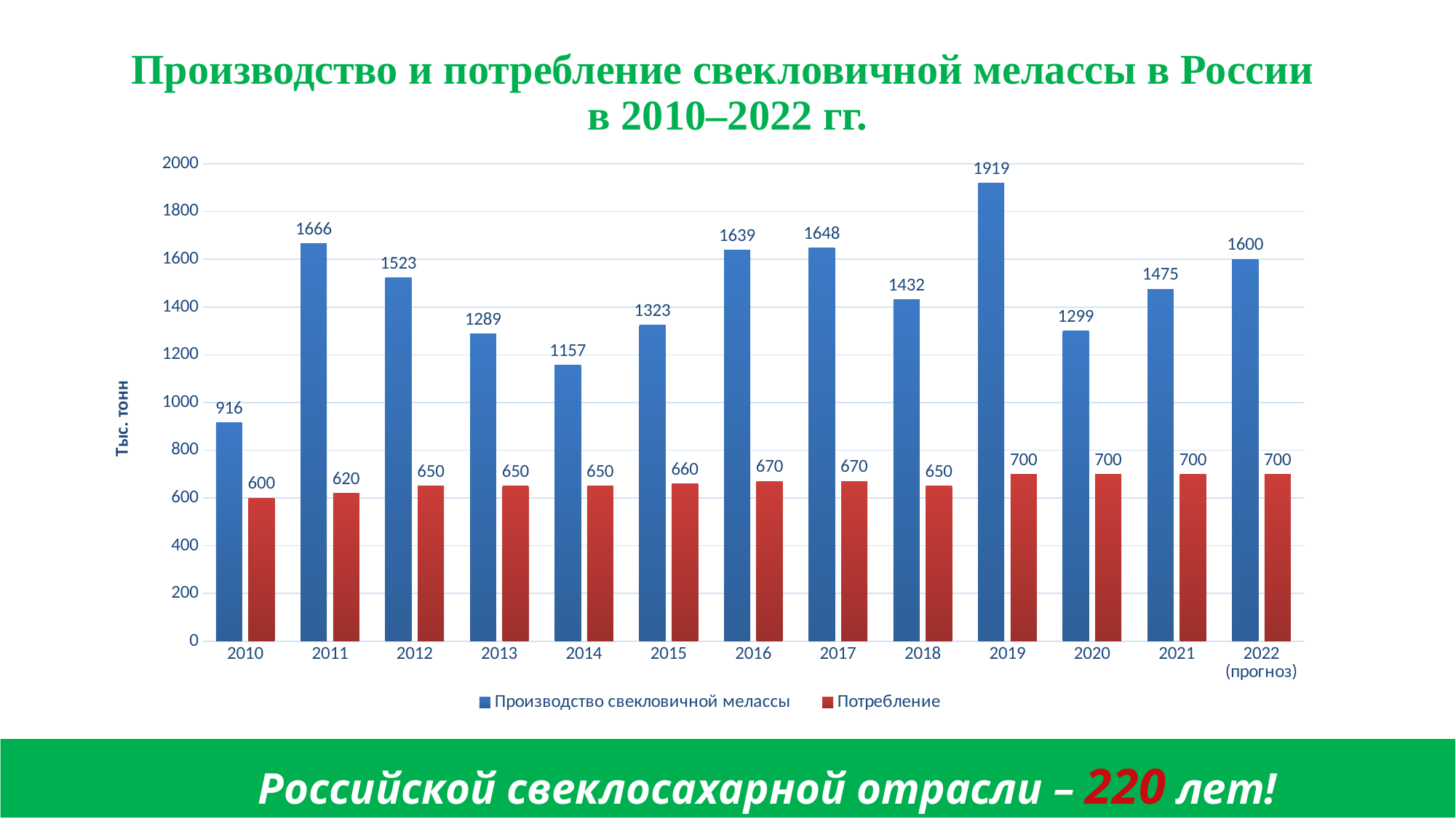
What is the difference between production and consumption in 2019? 1219 In which year was production of beet molasses highest? 2019 Did consumption rise or fall from 2010 to 2022? Rise What is the difference between production in 2011 and production in 2010? 750 How many series does the legend list? 2 What kind of chart is shown on the slide? Bar chart How many years are shown on the x axis? 13 What was consumption (Потребление) in 2011? 620 What was the production of beet molasses (Производство свекловичной мелассы) in 2019? 1919 Which is larger: production in 2016 or production in 2018? Production in 2016 What unit is shown on the vertical axis label? Тыс. тонн In which year was production of beet molasses lowest? 2010